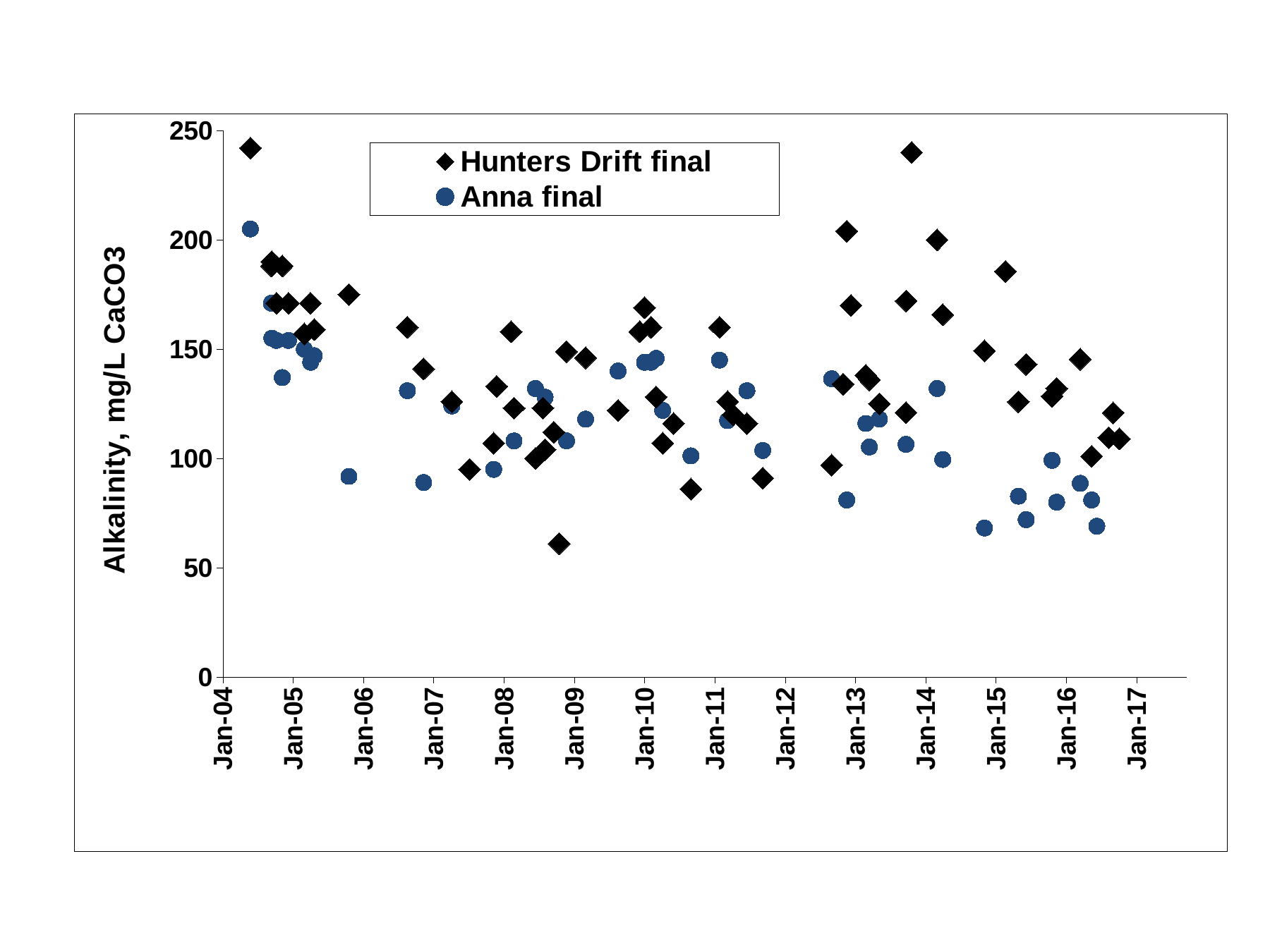
Is the first Hunters Drift final point, plotted just after Jan-04, greater or less than 200? greater Is the highest Hunters Drift final value greater or less than 200? greater How many series does the legend list? 2 What is the highest value shown on the vertical axis? 250 What kind of chart is shown on the slide? scatter chart Do the Anna final values generally rise or fall from Jan-04 to Jan-17? fall Which series contains the highest plotted point on the chart? Hunters Drift final Which series contains the lowest plotted point on the chart? Hunters Drift final What are the two series named in the legend? Hunters Drift final and Anna final Is the lowest Anna final value greater or less than 100? less What is the label on the vertical axis? Alkalinity, mg/L CaCO3